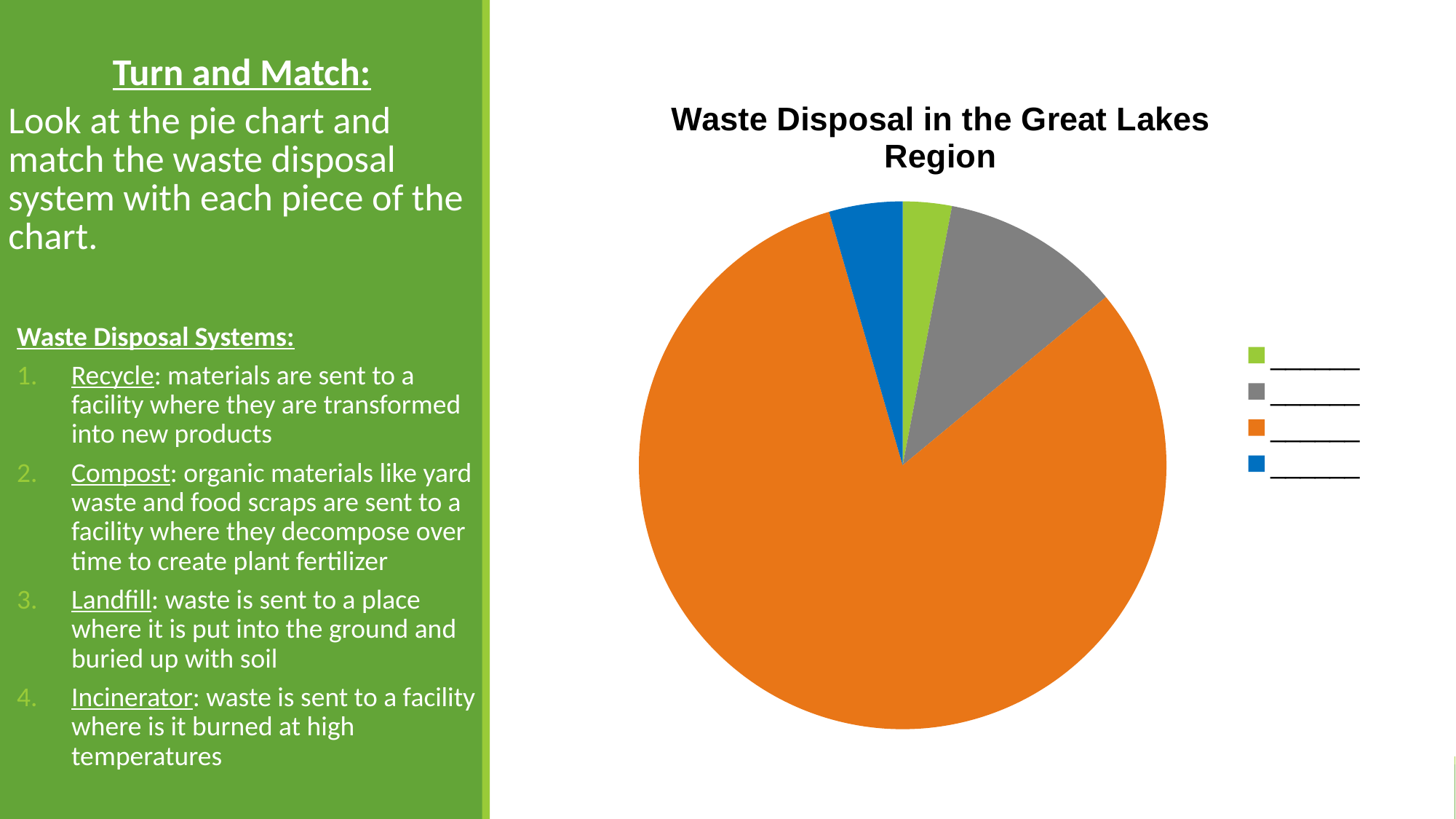
Which colour slice is the largest in the pie chart? orange Which is larger in the pie chart, the gray slice or the green slice? the gray slice What is the title of the pie chart? Waste Disposal in the Great Lakes Region How many entries does the legend of the pie chart list? 4 How many slices does the pie chart have? 4 Which is larger in the pie chart, the orange slice or the gray slice? the orange slice Which is larger in the pie chart, the gray slice or the blue slice? the gray slice What kind of chart is shown on the slide? pie chart